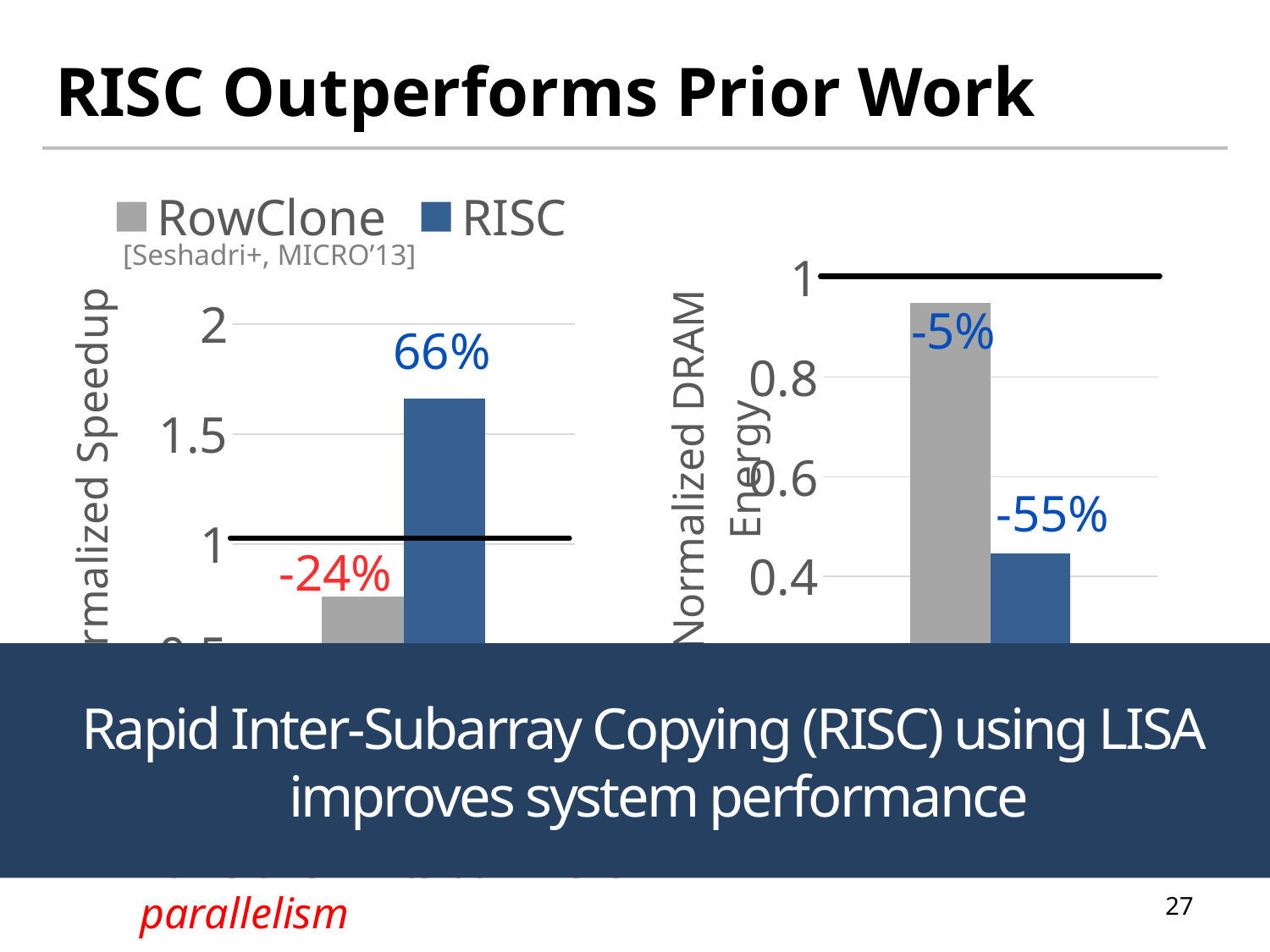
On the left chart (Normalized Speedup), is the RISC bar greater or less than 1.5? greater On the left chart (Normalized Speedup), is the RowClone bar greater or less than 1? less On the right chart (Normalized DRAM Energy), is the RISC bar greater or less than 0.6? less On the left chart (Normalized Speedup), what percentage label is shown above the RISC bar? 66% On the right chart (Normalized DRAM Energy), what percentage label is shown on the RowClone bar? -5% What kind of chart is the left chart (Normalized Speedup)? bar chart On the left chart (Normalized Speedup), what percentage label is shown above the RowClone bar? -24% On the left chart (Normalized Speedup), which bar is taller, RowClone or RISC? RISC On the right chart (Normalized DRAM Energy), which bar is taller, RowClone or RISC? RowClone How many series does the legend list? 2 On the right chart (Normalized DRAM Energy), what percentage label is shown next to the RISC bar? -55%